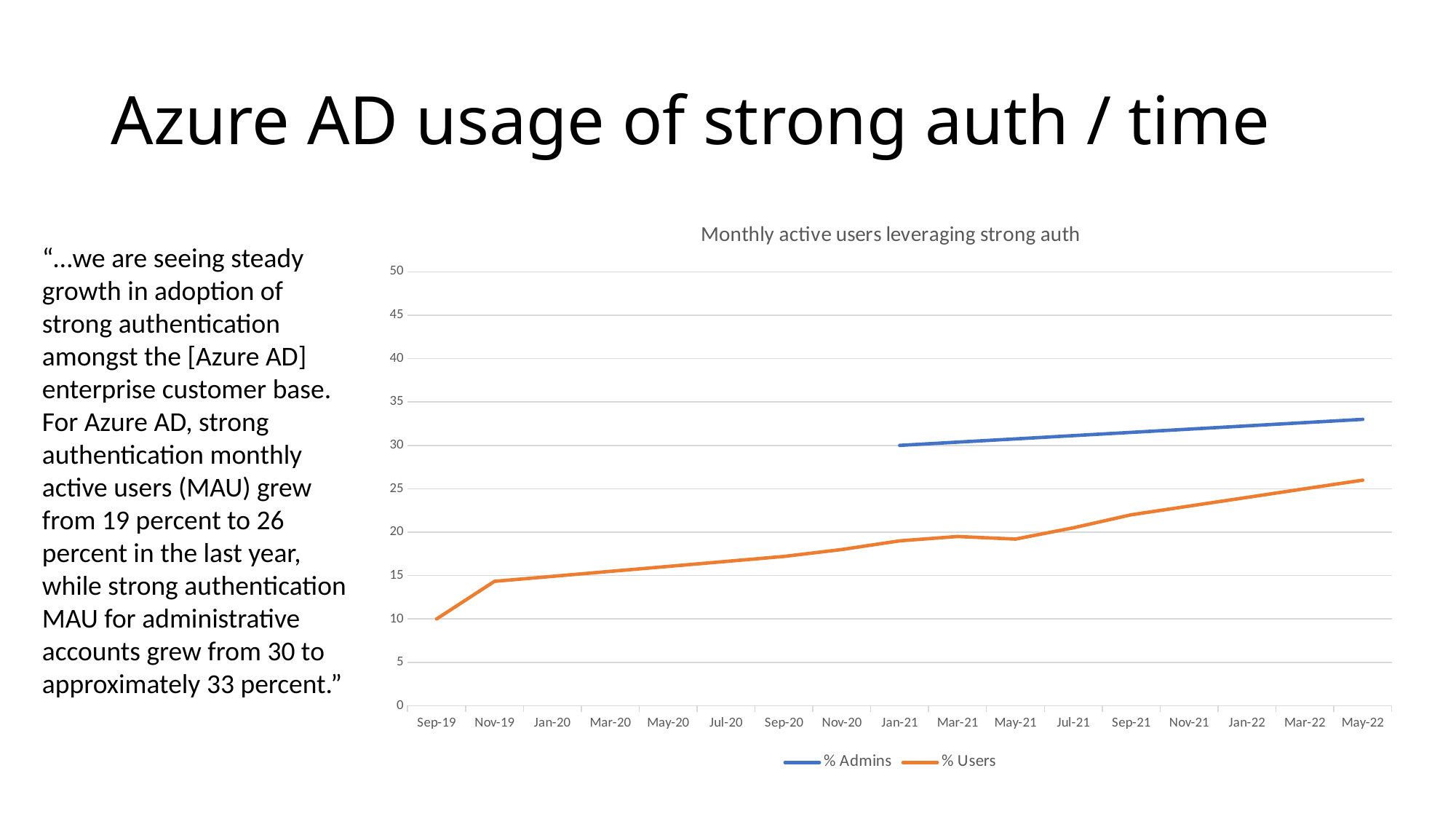
What is the value of % Admins at Jan-21? 30 How many date labels are shown along the x axis? 17 How many series does the chart legend list? 2 What type of chart is shown on the slide? line chart What are the two series named in the legend? % Admins and % Users What is the title of the chart? Monthly active users leveraging strong auth What is the value of % Users at Sep-19? 10 Is the value of % Admins at May-22 greater or less than 35? less Is the value of % Users at Nov-19 greater or less than 15? less Does the % Users line generally rise or fall from Sep-19 to May-22? rise Is the value of % Users at May-22 greater or less than 25? greater At May-22, which series has the higher value, % Admins or % Users? % Admins